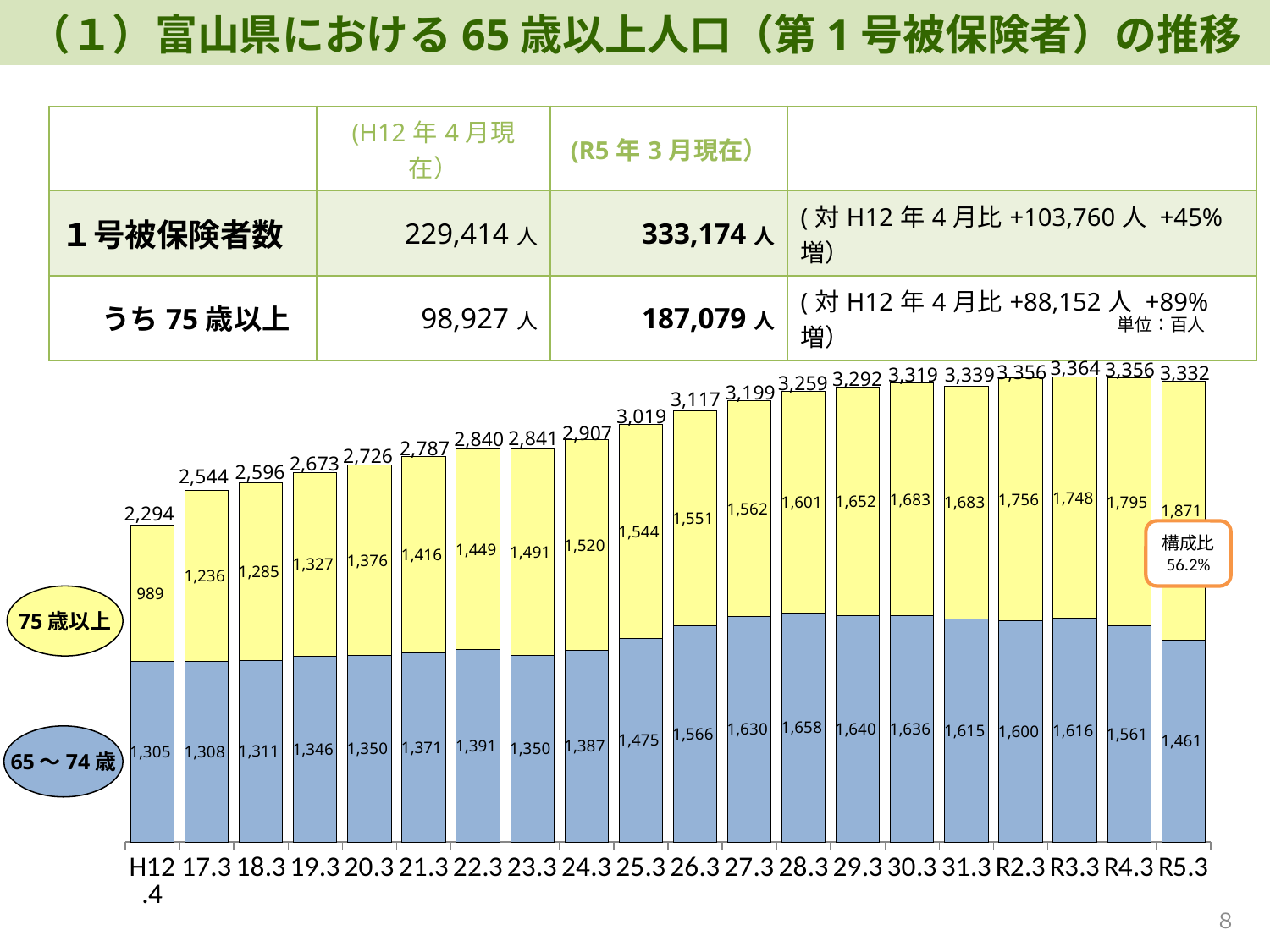
How many periods (bars) are shown on the x axis of the chart? 20 What is the difference between the 75歳以上 value in R5.3 and the 75歳以上 value in H12.4? 882 What is the total value shown above the bar for R5.3? 3,332 What is the value for 75歳以上 in R5.3? 1,871 How many series are stacked in each bar of the chart? 2 Which period has the lowest total value labeled above its bar? H12.4 What is the value for 75歳以上 in H12.4? 989 Which period has the highest total value labeled above its bar? R3.3 In R5.3, which is larger: the 75歳以上 value or the 65～74歳 value? 75歳以上 What is the value for 65～74歳 in R5.3? 1,461 What kind of chart is shown on the slide? Stacked bar chart What 構成比 percentage is shown in the callout next to the R5.3 bar? 56.2%